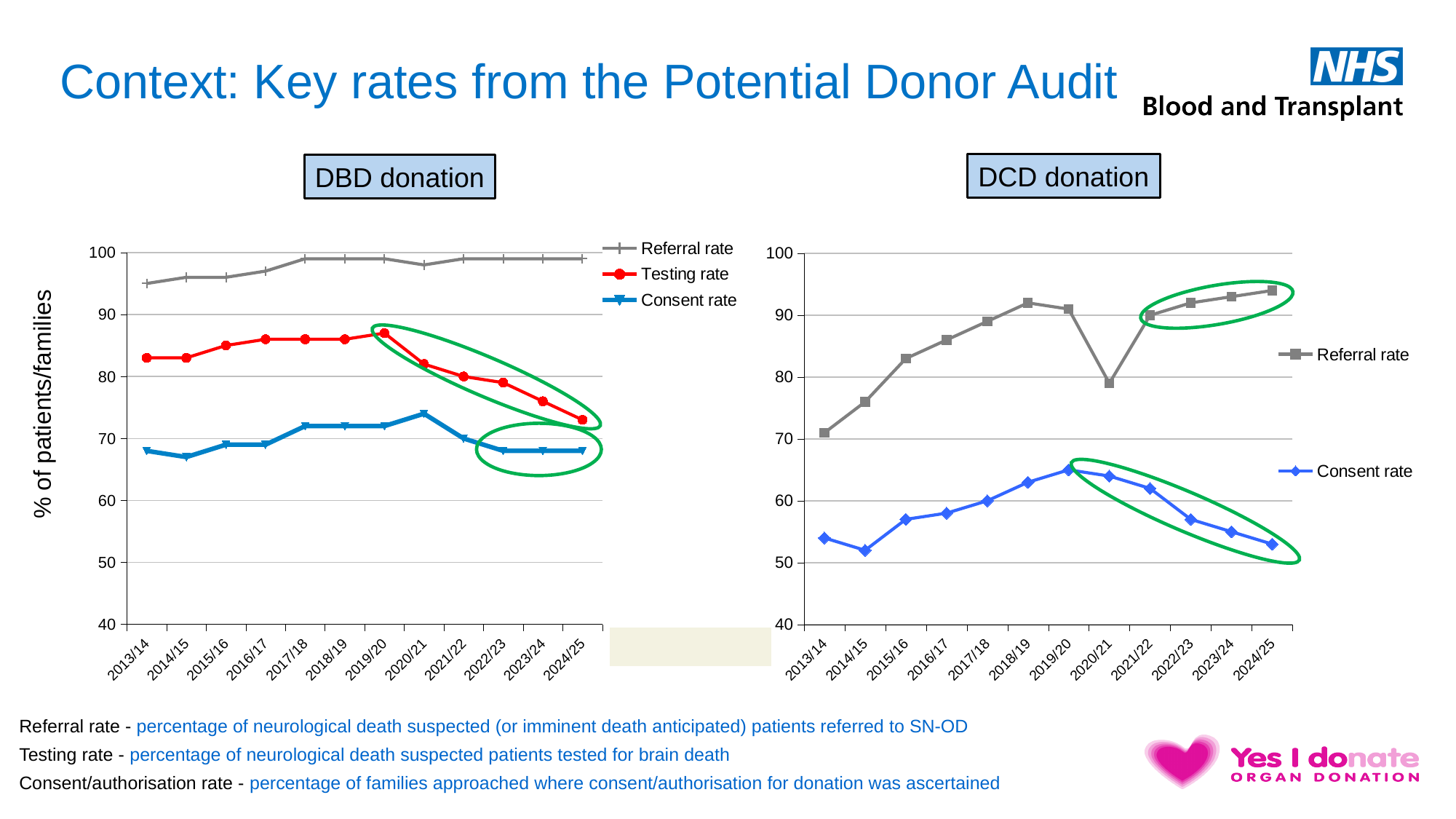
In the DBD donation chart, is the Testing rate for 2024/25 greater or less than 80? less How many years are shown on the x axis of the DBD donation chart? 12 In the DCD donation chart, is the Referral rate for 2013/14 greater or less than 80? less In the DCD donation chart, is the Consent rate for 2014/15 greater or less than 60? less How many series does the legend of the DBD donation chart list? 3 In the DBD donation chart, which series has the highest value in 2024/25? Referral rate How many series does the legend of the DCD donation chart list? 2 In the DCD donation chart, is the Consent rate larger in 2019/20 or in 2024/25? 2019/20 What kind of chart is the DBD donation chart? line chart In the DCD donation chart, which year has the lowest Referral rate? 2013/14 In the DCD donation chart, does the Consent rate rise or fall from 2019/20 to 2024/25? fall In the DBD donation chart, does the Testing rate rise or fall from 2019/20 to 2024/25? fall